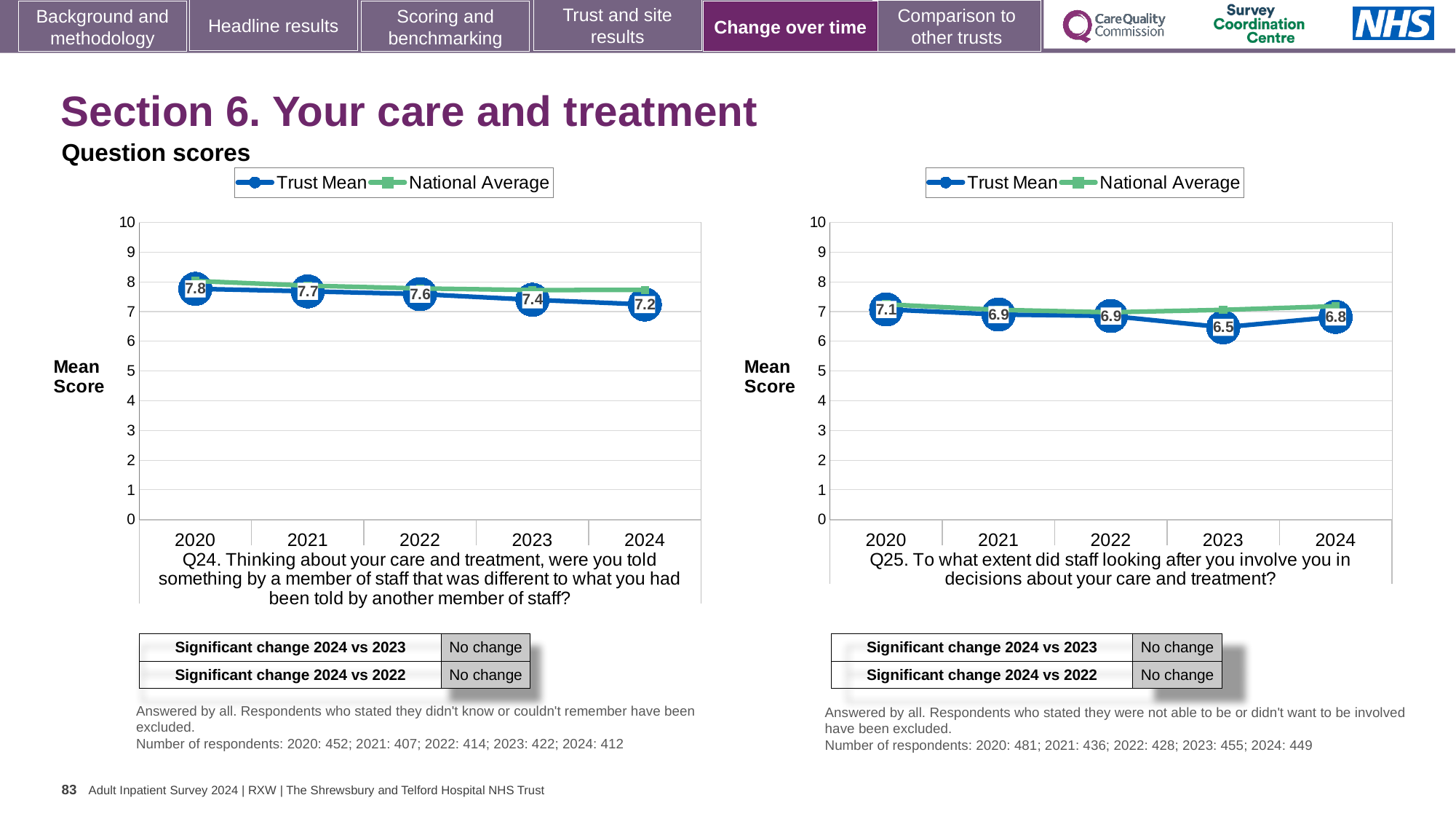
On the Q24 chart (left), what is the Trust Mean score for 2020? 7.8 On the Q25 chart (right), is the Trust Mean score for 2024 larger or smaller than for 2023? larger On the Q25 chart (right), which year has the highest Trust Mean score? 2020 On the Q24 chart (left), which year has the lowest Trust Mean score? 2024 On the Q24 chart (left), does the Trust Mean rise or fall from 2020 to 2024? fall How many years are plotted on the Q24 chart (left)? 5 On the Q25 chart (right), is the Trust Mean score for 2020 greater or less than 8? less On the Q25 chart (right), what is the Trust Mean score for 2023? 6.5 On the Q25 chart (right), which year has the lowest Trust Mean score? 2023 On the Q24 chart (left), what is the Trust Mean score for 2024? 7.2 On the Q24 chart (left), what is the difference between the Trust Mean scores for 2020 and 2024? 0.6 How many series does the legend of the Q25 chart (right) list? 2